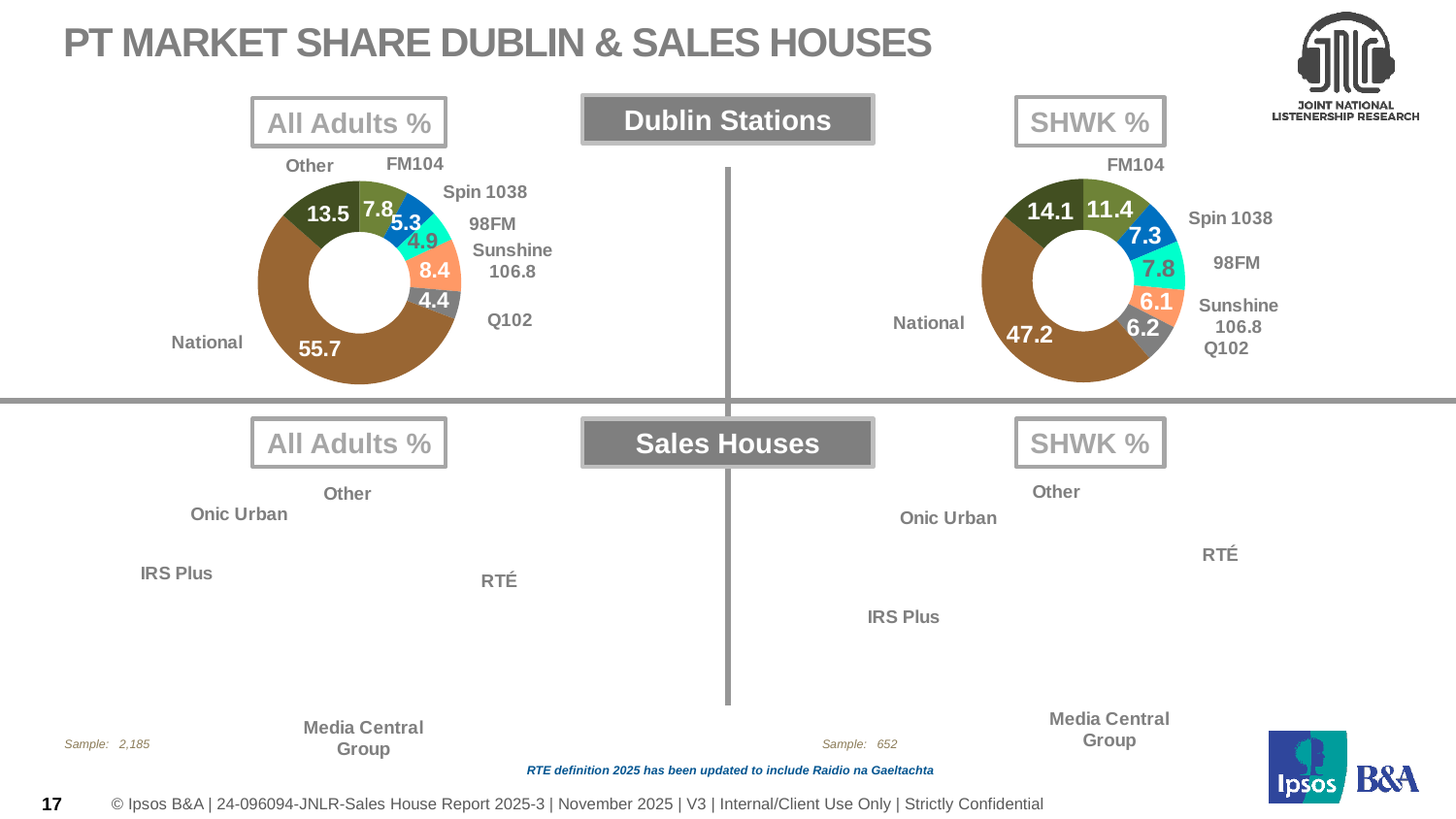
What is the difference between the National value in the Dublin Stations All Adults % chart and the National value in the Dublin Stations SHWK % chart? 8.5 What type of chart is used for the Dublin Stations All Adults % data? Pie (donut) chart In the Dublin Stations SHWK % chart, what is the value for 98FM? 7.8 How many segments are shown in the Dublin Stations All Adults % chart? 7 In the Dublin Stations All Adults % chart, what is the difference between Other and FM104? 5.7 In the Dublin Stations All Adults % chart, which is larger: Spin 1038 or 98FM? Spin 1038 In the Dublin Stations All Adults % chart, which segment has the smallest share? Q102 In the Dublin Stations SHWK % chart, what is the value for Spin 1038? 7.3 In the Dublin Stations All Adults % chart, what is the value for National? 55.7 In the Dublin Stations All Adults % chart, which segment has the largest share? National In the Dublin Stations All Adults % chart, what is the value for Sunshine 106.8? 8.4 In the Dublin Stations SHWK % chart, what is the value for National? 47.2